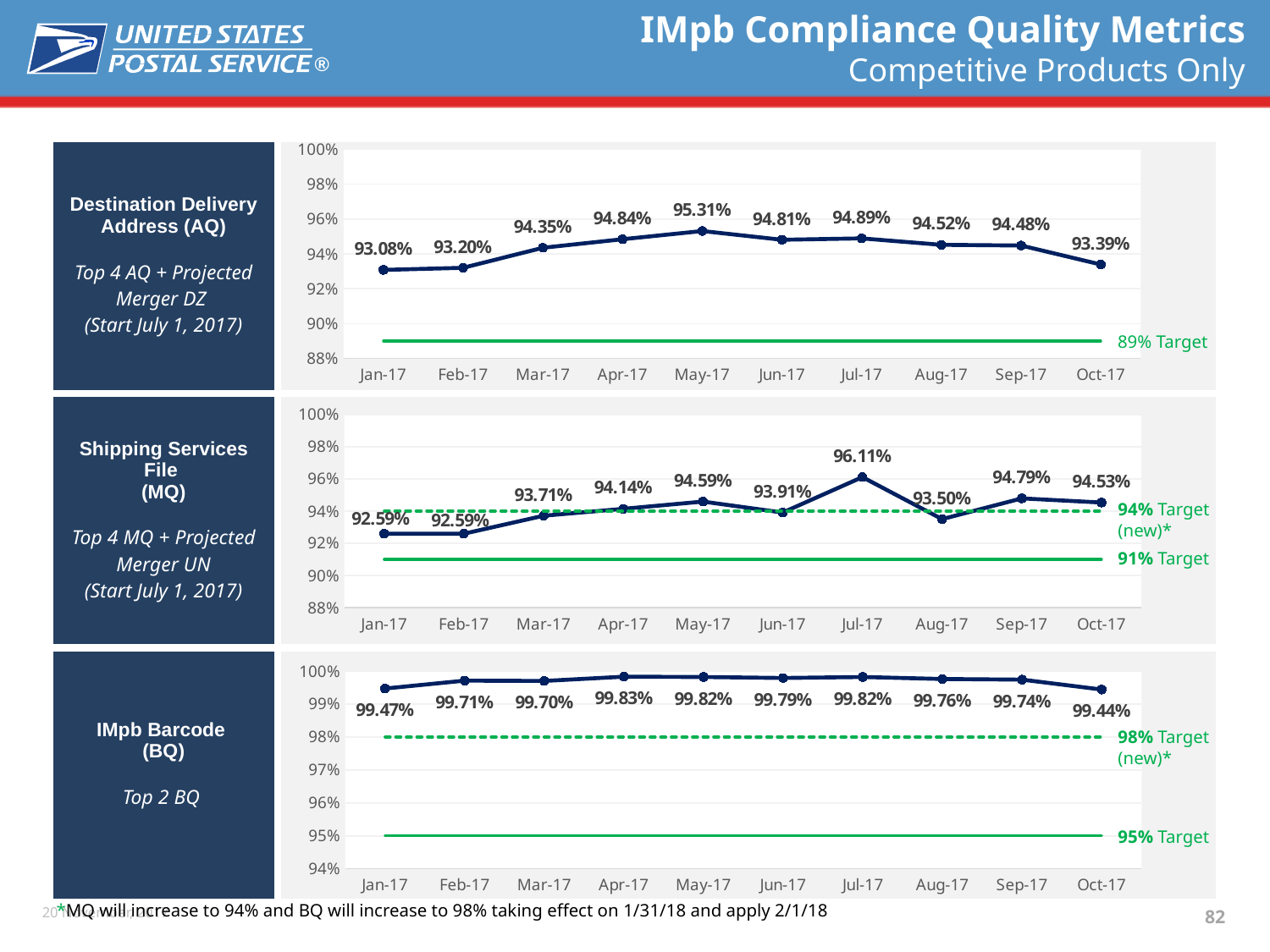
In the Destination Delivery Address (AQ) chart, which month has the highest value? May-17 In the Shipping Services File (MQ) chart, what is the value for Jul-17? 96.11% What type of chart is the Destination Delivery Address (AQ) chart? Line chart In the IMpb Barcode (BQ) chart, what is the difference between the Apr-17 and Jan-17 values? 0.36% In the Shipping Services File (MQ) chart, what is the value of the new target line? 94% In the IMpb Barcode (BQ) chart, what is the value for Oct-17? 99.44% In the Destination Delivery Address (AQ) chart, which month has the lowest value? Jan-17 How many months are plotted in the IMpb Barcode (BQ) chart? 10 In the Shipping Services File (MQ) chart, which month has the highest value? Jul-17 In the Destination Delivery Address (AQ) chart, what is the difference between the Oct-17 and Jan-17 values? 0.31% In the Destination Delivery Address (AQ) chart, what is the value for May-17? 95.31% In the Shipping Services File (MQ) chart, which is larger, the Aug-17 value or the Sep-17 value? Sep-17